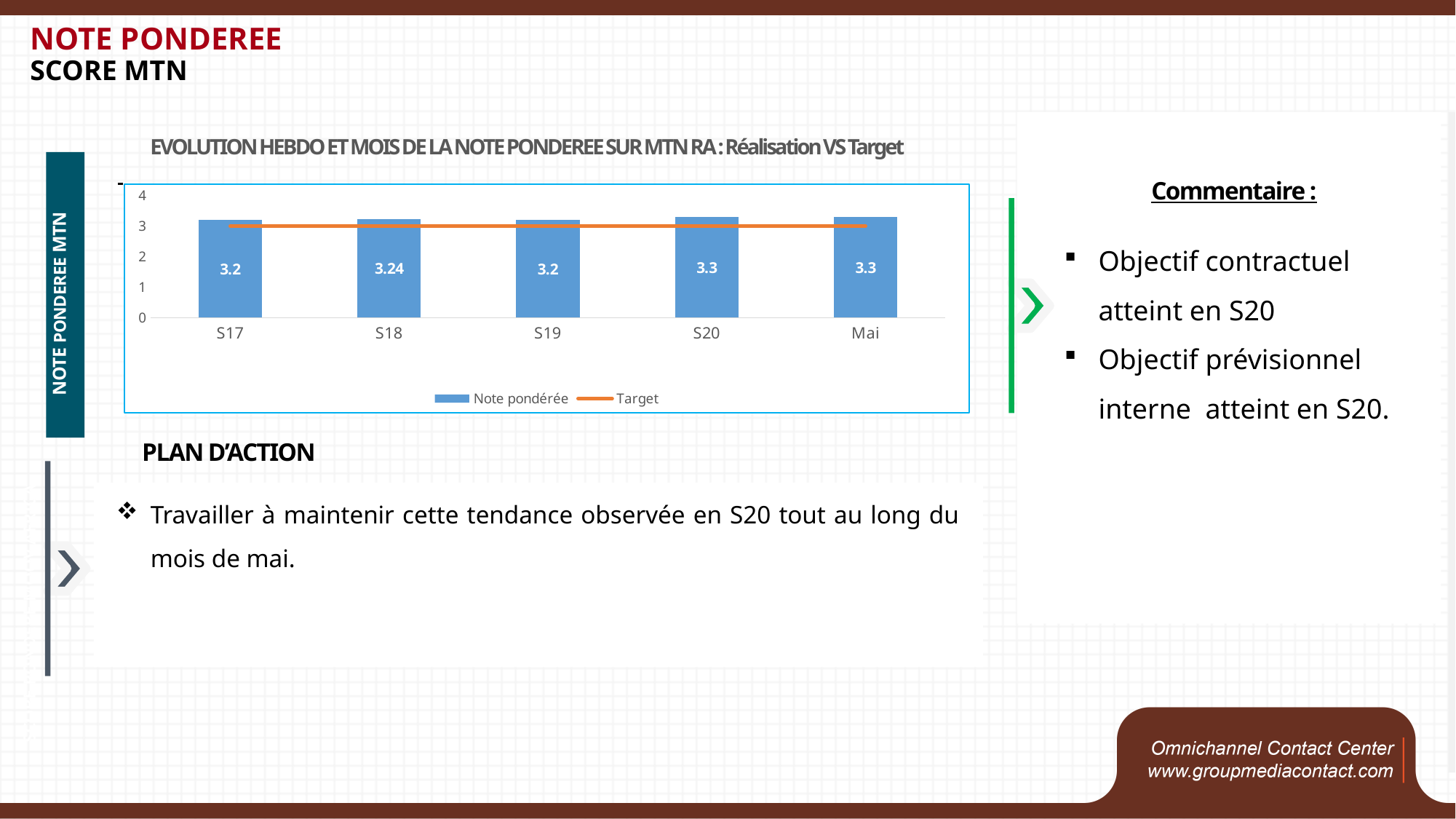
How many series does the chart legend list? 2 What is the Note pondérée value for S17? 3.2 How many categories are shown on the x axis of the chart? 5 What are the two entries in the chart legend? Note pondérée and Target What kind of chart is used to show the Note pondérée values? Bar chart What is the Note pondérée value for S20? 3.3 Is the Note pondérée value for S19 greater or less than 2? greater Which has the larger Note pondérée value, S18 or S19? S18 What is the Note pondérée value for S18? 3.24 What is the difference between the Note pondérée values for S20 and S19? 0.1 What is the Note pondérée value for Mai? 3.3 What is the difference between the Note pondérée values for S18 and S17? 0.04